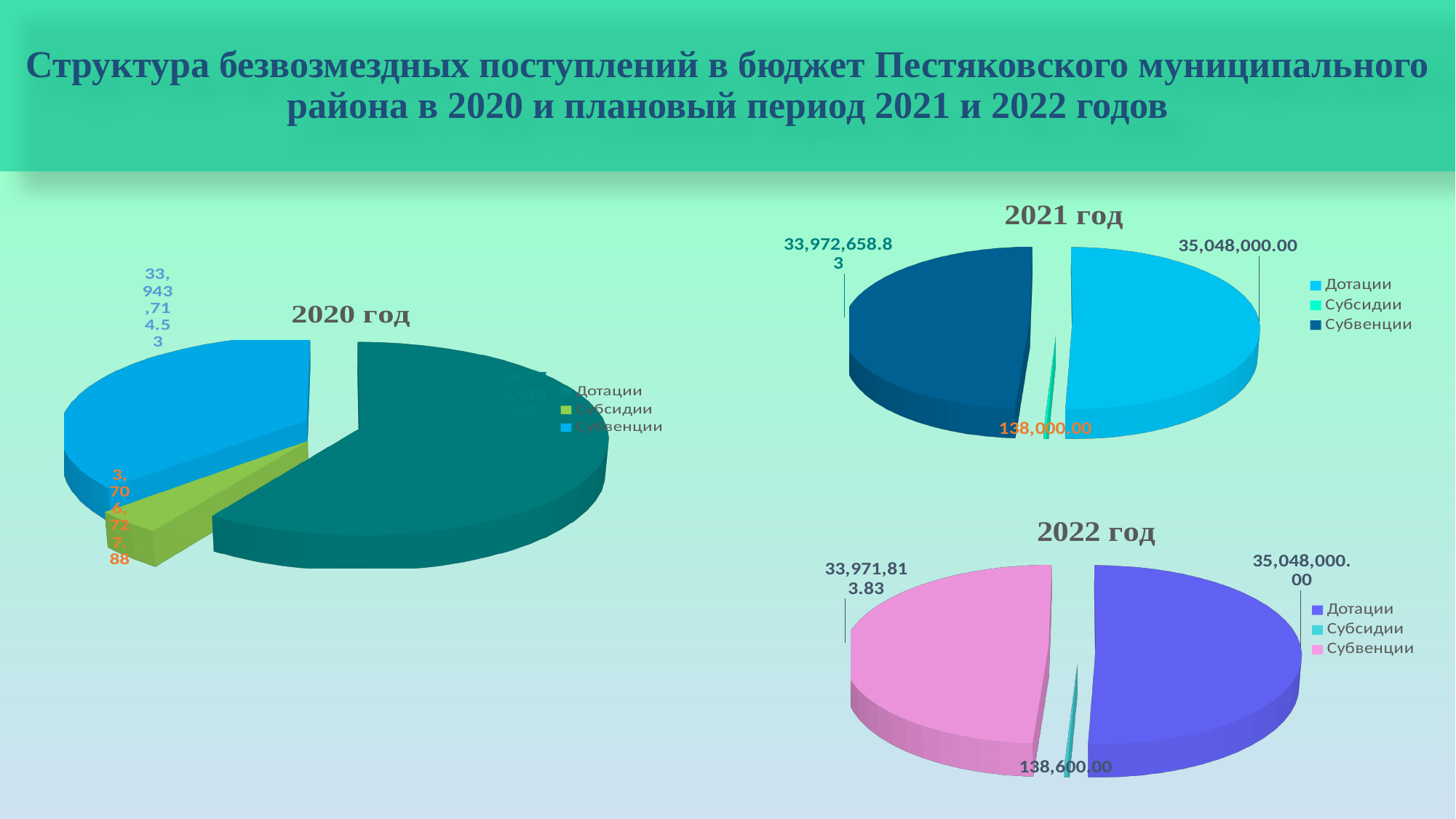
In the 2021 год chart, what is the value for Дотации? 35,048,000.00 How many entries does the legend of the 2021 год chart list? 3 In the 2022 год chart, what is the value for Субвенции? 33,971,813.83 In the 2021 год chart, which category has the largest value? Дотации In the 2022 год chart, which category has the smallest value? Субсидии How many slices does the 2022 год chart have? 3 In the 2021 год chart, what is the value for Субсидии? 138,000.00 What kind of chart is the 2020 год chart? Pie chart In the 2021 год chart, what is the value for Субвенции? 33,972,658.83 In the 2022 год chart, which is larger, Дотации or Субвенции? Дотации In the 2021 год chart, what is the difference between Дотации and Субвенции? 1,075,341.17 In the 2022 год chart, what is the value for Субсидии? 138,600.00